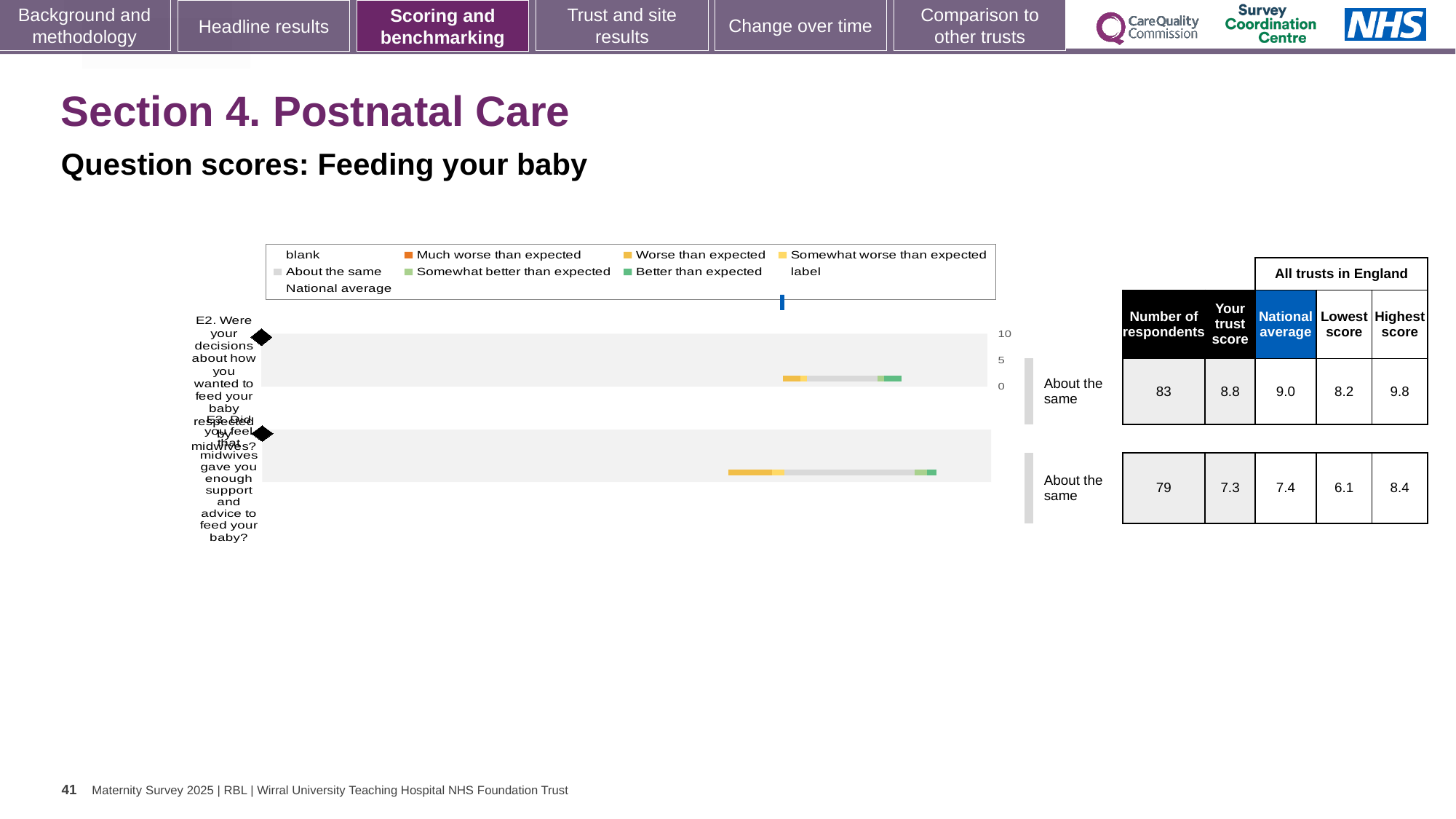
Which question has the higher trust score, E2 or E3? E2 According to the table beside the chart, what is the national average for E3 (midwives gave you enough support and advice to feed your baby)? 7.4 What colour does the legend use for 'Better than expected'? green What is the difference between the highest score and the lowest score for E2? 1.6 According to the table beside the chart, what is the lowest score among all trusts in England for E3? 6.1 According to the table beside the chart, how many respondents answered E2? 83 According to the table beside the chart, what is the trust score for E2 (decisions about how you wanted to feed your baby respected by midwives)? 8.8 By how much does the national average exceed the trust score for E2? 0.2 What kind of chart is shown on the slide? bar chart How many questions (categories) are plotted in the chart? 2 What is the difference between the highest score and the lowest score for E3? 2.3 What benchmark category is shown next to the chart for E3? About the same